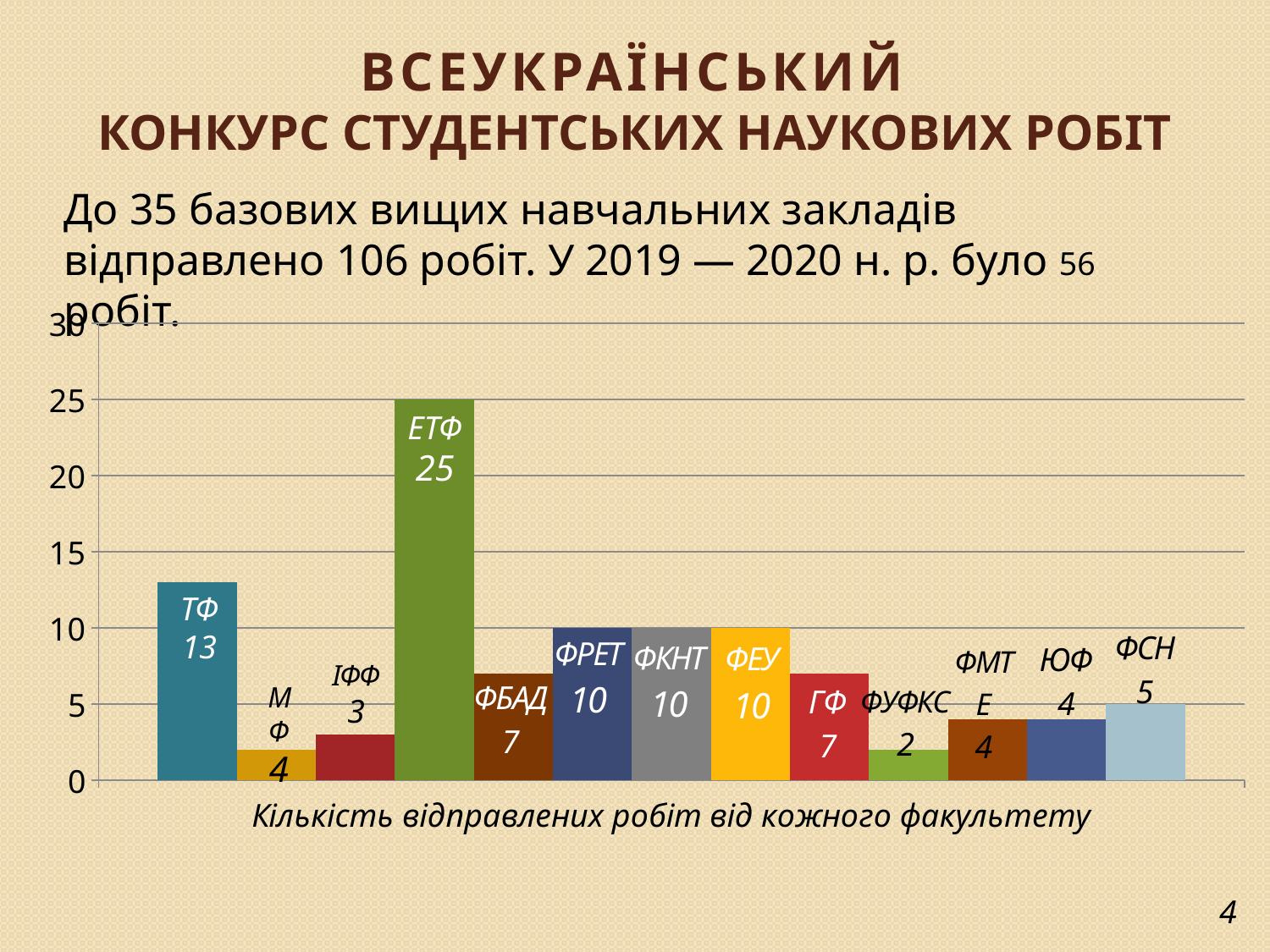
What is the value shown for ФУФКС? 2 What is the value shown for ТФ? 13 Is the value for ЕТФ greater or less than 20? greater What is the difference between the values for ЕТФ and ТФ? 12 Which is larger, the value for ФБАД or the value for ФРЕТ? ФРЕТ What is the value shown for ФСН? 5 Which faculty has the highest number of sent works? ЕТФ What type of chart is shown on the slide? bar chart How many works were sent from ЕТФ according to the chart? 25 What is the label shown below the x axis of the chart? Кількість відправлених робіт від кожного факультету How many faculties (bars) are shown in the chart? 13